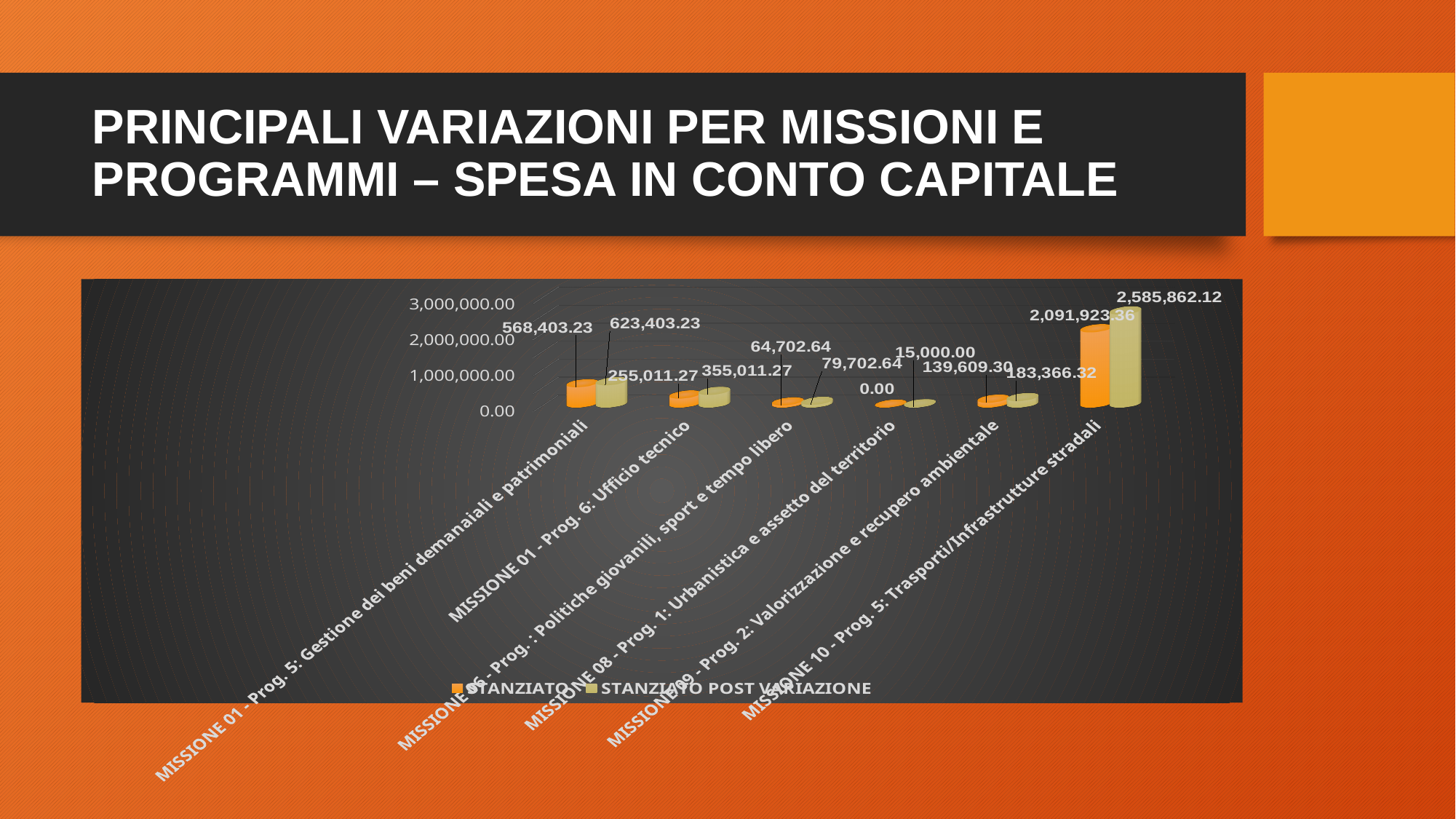
What is the STANZIATO value for MISSIONE 10 - Prog. 5: Trasporti/Infrastrutture stradali? 2,091,923.36 What is the STANZIATO POST VARIAZIONE value for MISSIONE 01 - Prog. 6: Ufficio tecnico? 355,011.27 What is the difference between the STANZIATO POST VARIAZIONE and STANZIATO values for MISSIONE 01 - Prog. 6: Ufficio tecnico? 100,000.00 Which category has the lowest STANZIATO value? MISSIONE 08 - Prog. 1: Urbanistica e assetto del territorio How many categories are shown on the x axis of the chart? 6 What is the STANZIATO value for MISSIONE 08 - Prog. 1: Urbanistica e assetto del territorio? 0.00 What kind of chart is shown on the slide? Bar chart Which is larger for MISSIONE 06 - Prog. : Politiche giovanili, sport e tempo libero: the STANZIATO value or the STANZIATO POST VARIAZIONE value? STANZIATO POST VARIAZIONE What is the difference between the STANZIATO POST VARIAZIONE and STANZIATO values for MISSIONE 10 - Prog. 5: Trasporti/Infrastrutture stradali? 493,938.76 What is the STANZIATO POST VARIAZIONE value for MISSIONE 09 - Prog. 2: Valorizzazione e recupero ambientale? 183,366.32 How many series does the chart legend list? 2 Which category has the highest STANZIATO POST VARIAZIONE value? MISSIONE 10 - Prog. 5: Trasporti/Infrastrutture stradali